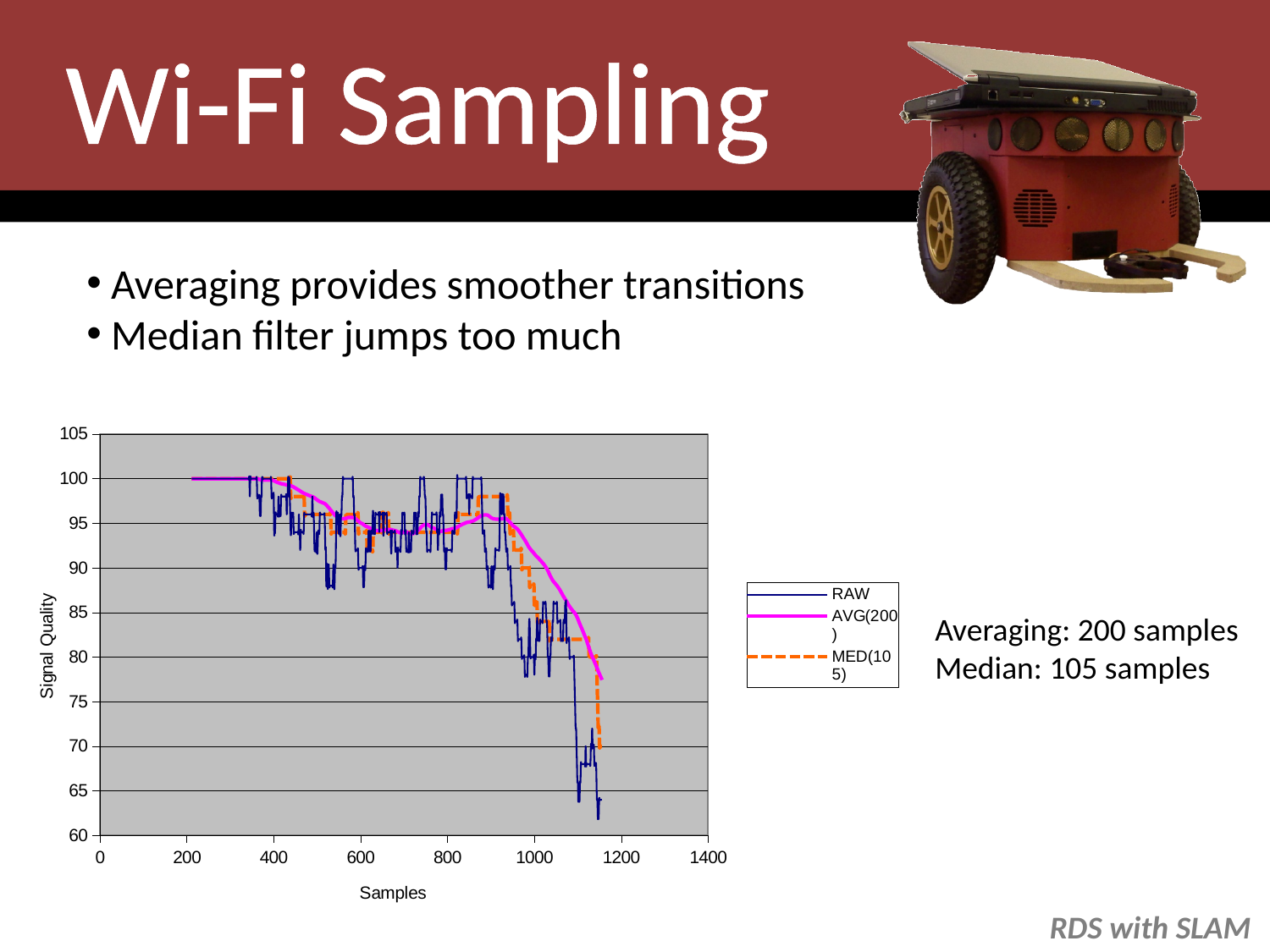
Is the value of the RAW series at around 1000 samples greater or less than 90? less Overall, does the signal quality rise or fall as the number of samples increases? fall Is the value of the AVG(200) series at its right-hand end greater or less than 75? greater Is the lowest value reached by the RAW series less or greater than 65? less Which series reaches a lower value at the right-hand end of the chart, RAW or AVG(200)? RAW What is the highest value shown on the vertical axis of the chart? 105 What kind of chart is shown on the slide? line chart How many series does the chart's legend list? 3 What is the title of the chart's horizontal axis? Samples What is the title of the chart's vertical axis? Signal Quality